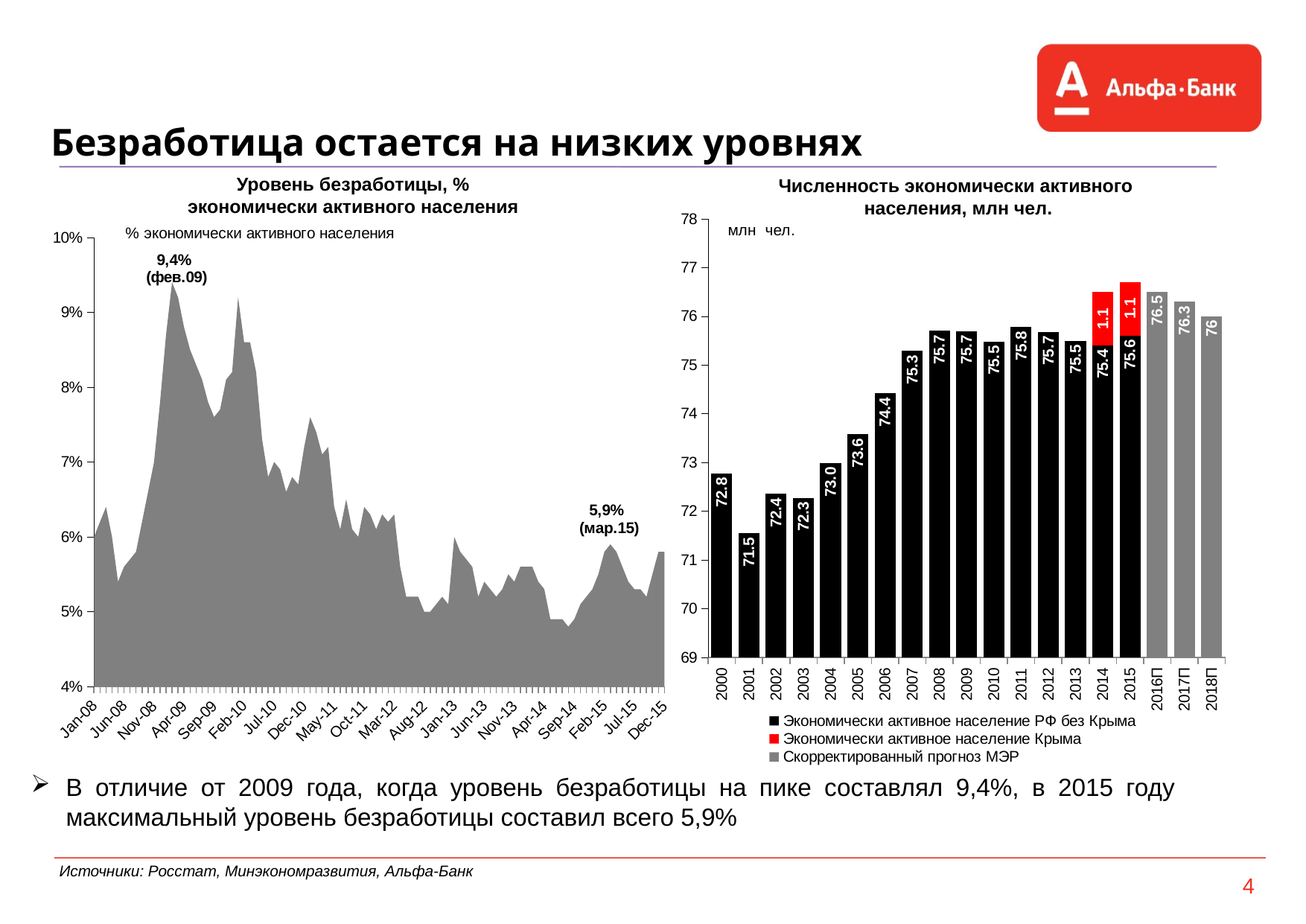
On the right chart (Численность экономически активного населения), what is the forecast value for 2017П? 76.3 On the right chart (Численность экономически активного населения), how many series does the legend list? 3 On the right chart (Численность экономически активного населения), which is larger: the value for 2005 or the value for 2006? 2006 On the right chart (Численность экономически активного населения), what is the total of the stacked bar for 2014? 76.5 On the right chart (Численность экономически активного населения), what is the value of the Crimea segment (Экономически активное население Крыма) in 2015? 1.1 On the left chart (Уровень безработицы), does the unemployment rate overall rise or fall from its February 2009 peak to December 2015? Fall On the left chart (Уровень безработицы), what is the difference between the labelled peak of February 2009 and the labelled value of March 2015? 3,5 percentage points On the left chart (Уровень безработицы), what was the peak unemployment rate labelled in February 2009? 9,4% On the right chart (Численность экономически активного населения), what is the value for 2000? 72.8 On the left chart (Уровень безработицы), what unemployment rate is labelled for March 2015? 5,9% On the right chart (Численность экономически активного населения), which year has the lowest value? 2001 What kind of chart is the left chart (Уровень безработицы)? Area chart